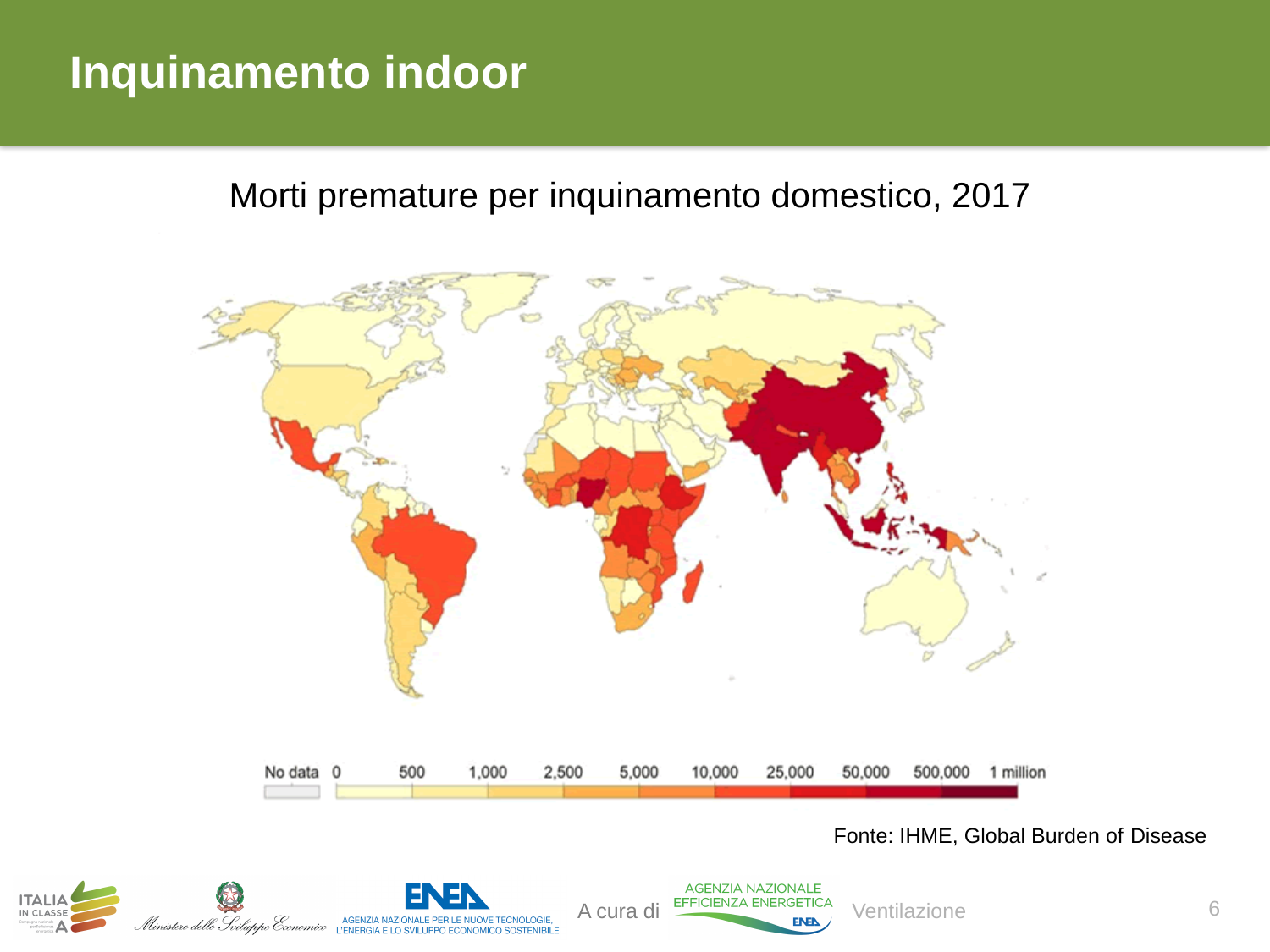
Which year does the map refer to? 2017 What label does the map's legend use for countries without data? No data What is the title of the map on the slide? Morti premature per inquinamento domestico, 2017 What is the source cited for the map? IHME, Global Burden of Disease What is the highest value shown on the map's colour legend? 1 million What kind of chart is shown on the slide? A world map (choropleth map) What is the lowest numeric value shown on the map's colour legend? 0 How many numeric tick labels does the map's colour legend show? 10